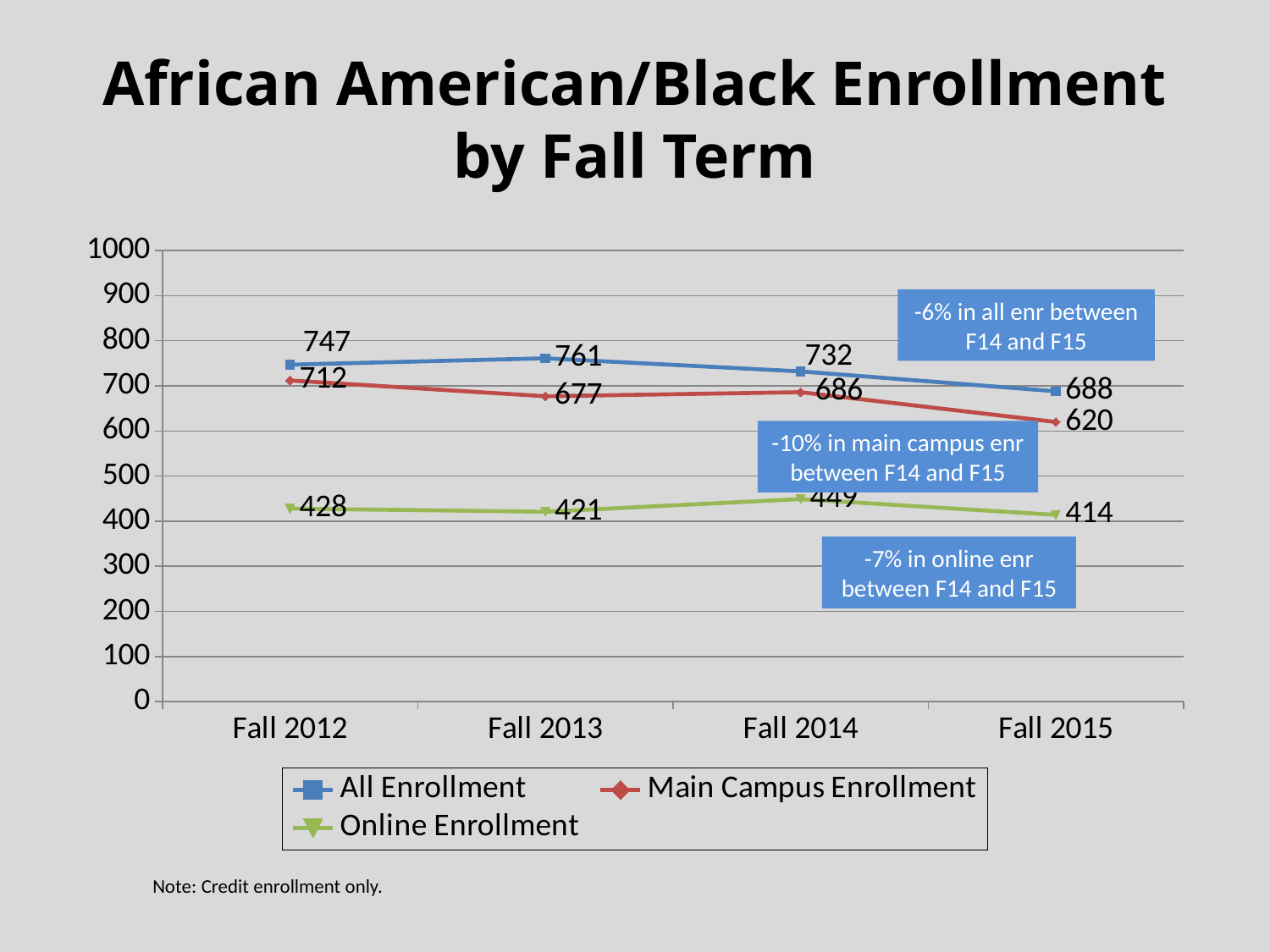
What is the Main Campus Enrollment value for Fall 2015? 620 How many series does the legend list? 3 In which fall term is Online Enrollment lowest? Fall 2015 Which is larger: Main Campus Enrollment in Fall 2013 or in Fall 2014? Fall 2014 What is the difference between All Enrollment and Main Campus Enrollment in Fall 2012? 35 Does Main Campus Enrollment rise or fall between Fall 2014 and Fall 2015? Fall What is the All Enrollment value for Fall 2013? 761 What kind of chart is shown on the slide? Line chart What is the Online Enrollment value for Fall 2014? 449 How many fall terms are shown on the x axis? 4 According to the callout on the chart, what was the percentage change in main campus enrollment between F14 and F15? -10% In which fall term is All Enrollment highest? Fall 2013